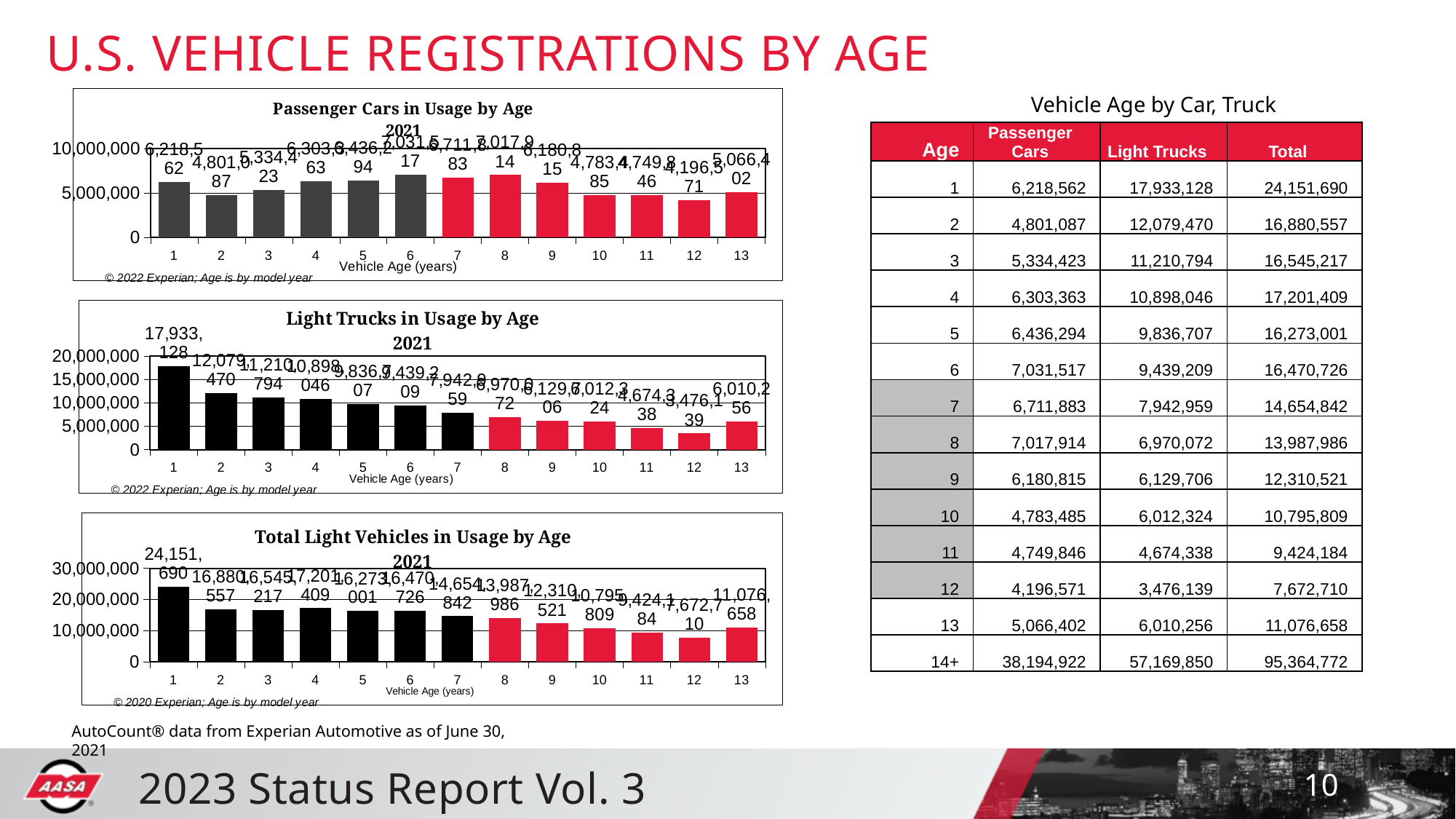
On the Light Trucks in Usage by Age chart, what is the value for vehicle age 1? 17,933,128 On the Total Light Vehicles in Usage by Age chart, what is the value for vehicle age 1? 24,151,690 On the Passenger Cars in Usage by Age chart, what kind of chart is shown? bar chart On the Light Trucks in Usage by Age chart, do the values generally rise or fall from vehicle age 1 to vehicle age 12? fall On the Passenger Cars in Usage by Age chart, is the value for vehicle age 1 greater or less than 5,000,000? greater On the Total Light Vehicles in Usage by Age chart, what is the x-axis label? Vehicle Age (years) On the Total Light Vehicles in Usage by Age chart, which is larger, the value for vehicle age 2 or vehicle age 12? vehicle age 2 On the Passenger Cars in Usage by Age chart, which vehicle age has the lowest value? 12 On the Light Trucks in Usage by Age chart, which vehicle age has the highest value? 1 On the Light Trucks in Usage by Age chart, which vehicle age has the lowest value? 12 On the Light Trucks in Usage by Age chart, what is the difference between the values for vehicle age 1 and vehicle age 2? 5,853,658 On the Passenger Cars in Usage by Age chart, how many vehicle age categories are plotted? 13